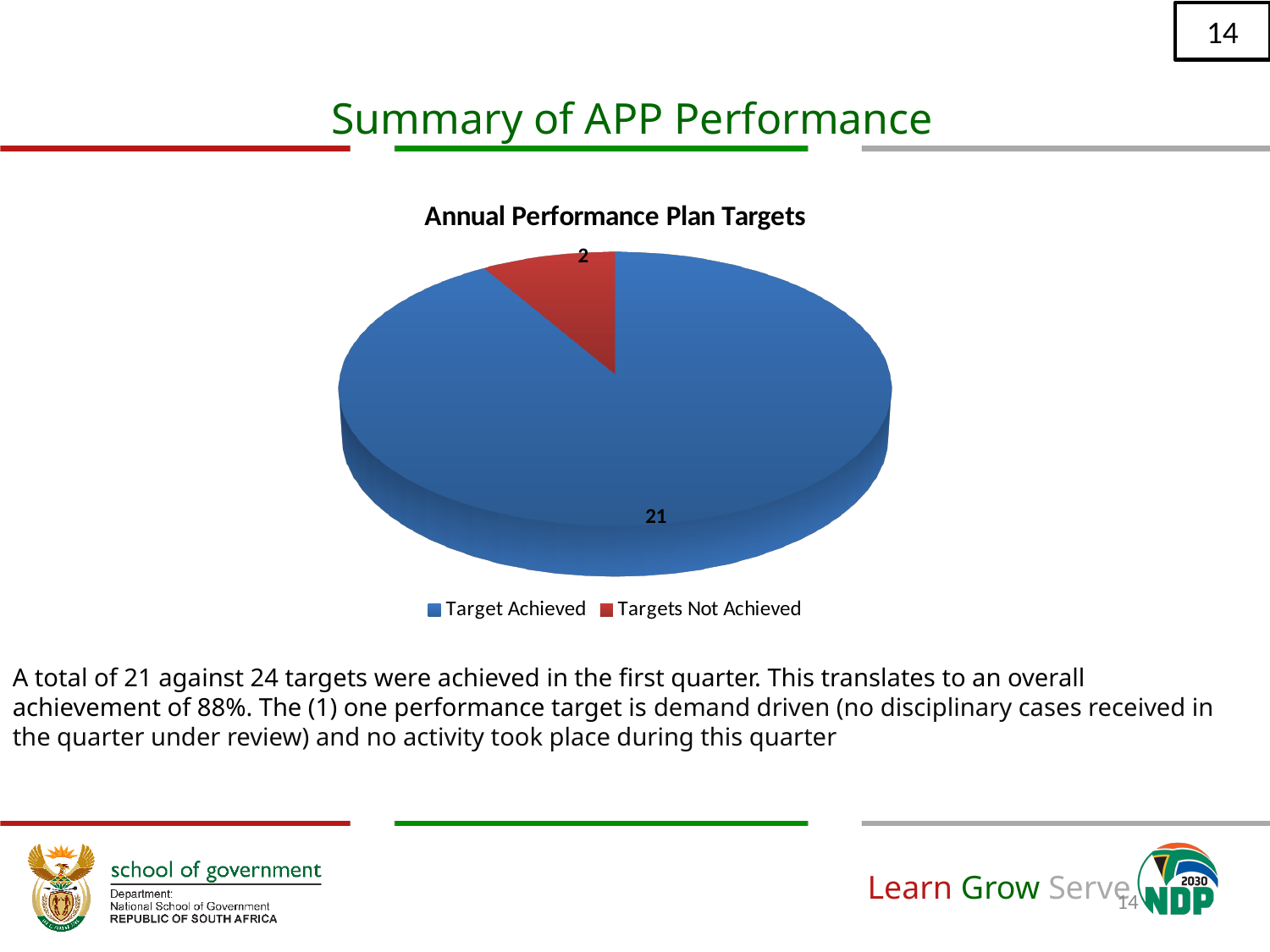
Which slice of the pie chart is the smallest? Targets Not Achieved What is the title of the chart? Annual Performance Plan Targets How many slices does the pie chart have? 2 How many entries does the legend list? 2 What is the value shown for Target Achieved? 21 Which is larger, Target Achieved or Targets Not Achieved? Target Achieved What type of chart is shown on the slide? Pie chart What is the total of the two values shown on the pie chart? 23 Which slice of the pie chart is the largest? Target Achieved What colour is the Targets Not Achieved slice? Red What is the difference between the Target Achieved value and the Targets Not Achieved value? 19 What is the value shown for Targets Not Achieved? 2